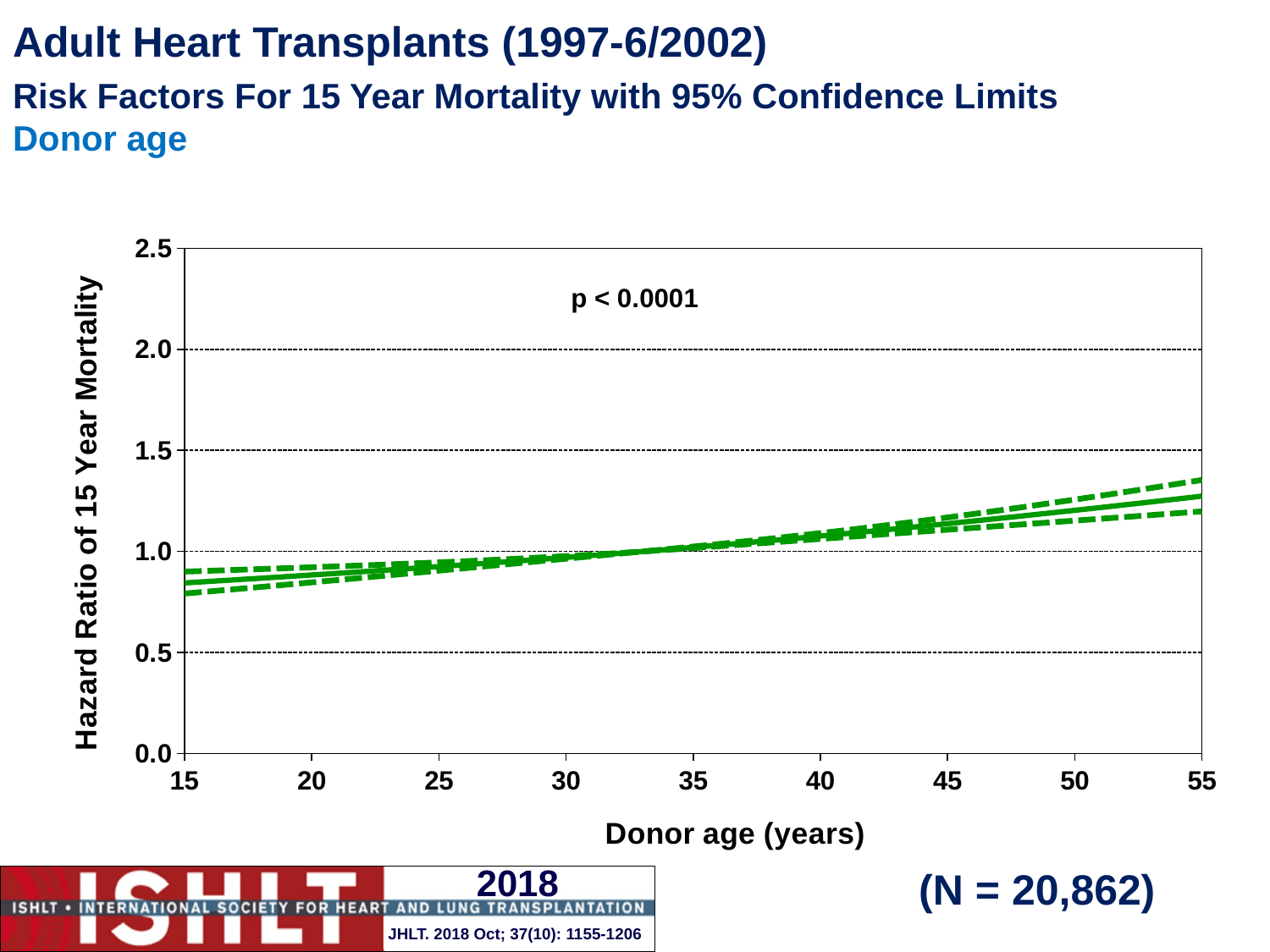
Is the hazard ratio higher at a donor age of 55 years or at a donor age of 15 years? 55 years Is the hazard ratio at a donor age of 15 years greater or less than 1.0? less What kind of chart is shown on the slide? line chart Does the hazard ratio of 15 year mortality rise or fall as donor age increases from 15 to 55 years? rise Is the hazard ratio at a donor age of 15 years greater or less than 0.5? greater What is the sample size (N) shown on the slide? N = 20,862 What is the highest value shown on the y axis? 2.5 Is the hazard ratio at a donor age of 55 years greater or less than 1.0? greater What is the label of the x axis? Donor age (years) How many lines (including the confidence limit lines) are plotted on the chart? 3 What is the p-value shown on the chart? p < 0.0001